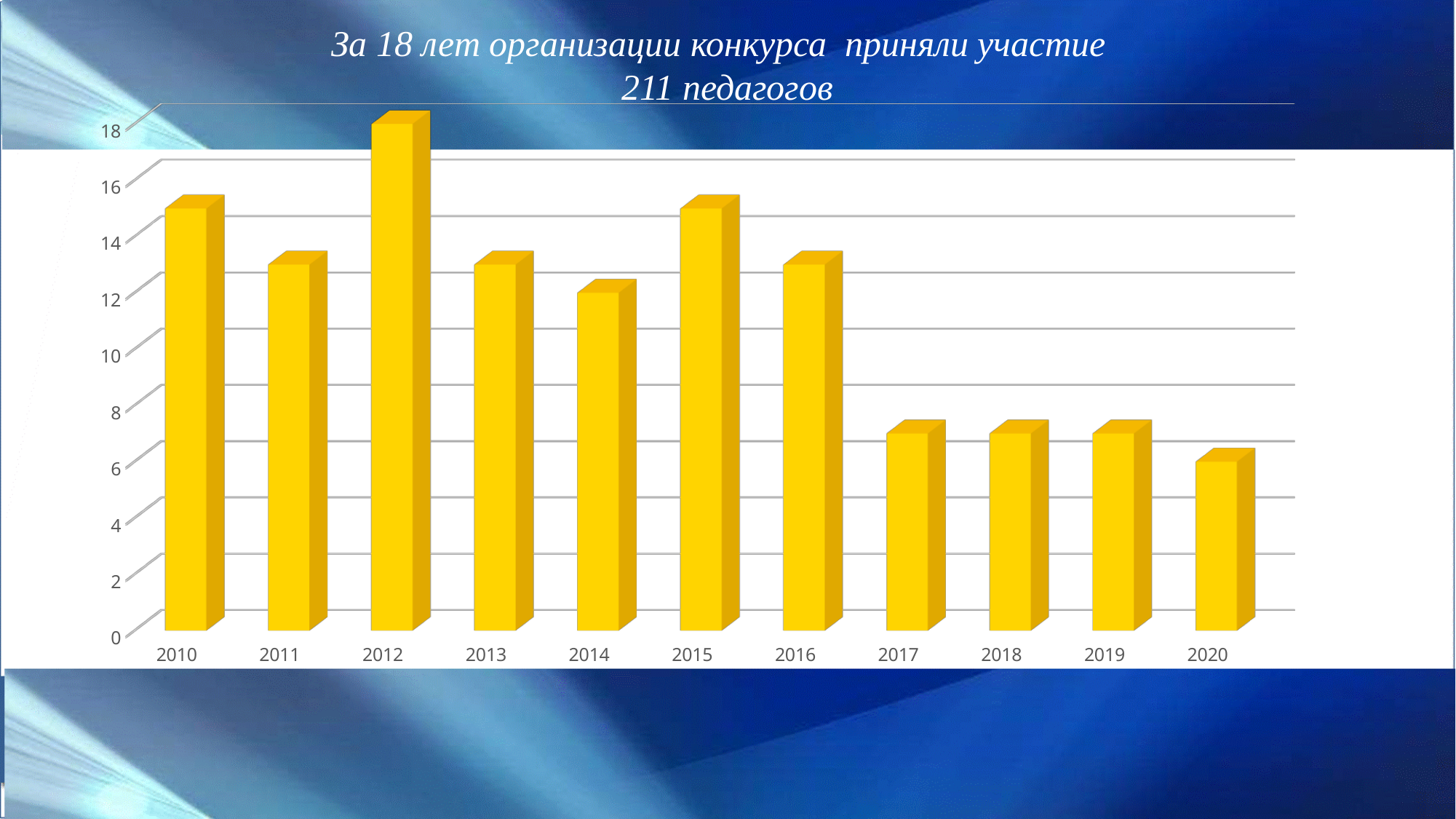
Which is larger, the value for 2010 or the value for 2011? 2010 Is the value for 2017 greater or less than 8? less How many years are shown on the x axis of the chart? 11 Which year has the lowest bar in the chart? 2020 Do the values generally rise or fall from 2010 to 2020? fall Which is larger, the value for 2015 or the value for 2016? 2015 Which year has the highest bar in the chart? 2012 What kind of chart is shown on the slide? bar chart Is the value for 2020 greater or less than 4? greater Is the value for 2012 greater or less than 16? greater